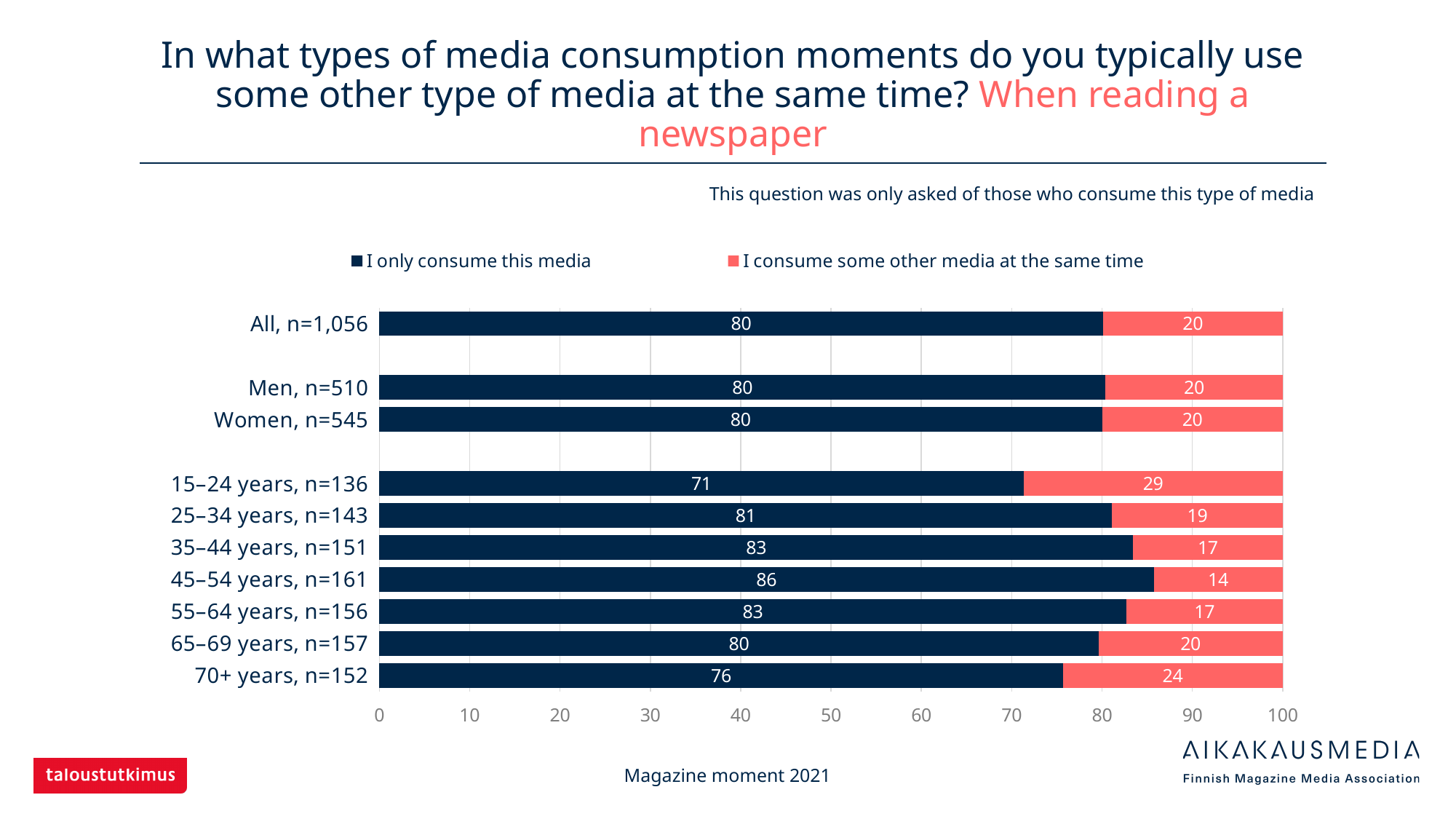
What colour represents "I consume some other media at the same time" in the chart? Red (coral) What is the value for "I only consume this media" for All, n=1,056? 80 What is the value for "I only consume this media" for the 15–24 years group? 71 Which age group has the highest value for "I only consume this media"? 45–54 years, n=161 How many series does the legend list? 2 What kind of chart is shown on the slide? Stacked bar chart Which age group has the lowest value for "I only consume this media"? 15–24 years, n=136 What is the difference between the "I consume some other media at the same time" values for the 15–24 years group and the 45–54 years group? 15 What is the value for "I consume some other media at the same time" for the 70+ years group? 24 Which is larger: the "I only consume this media" value for 25–34 years or for 70+ years? 25–34 years What is the total of the stacked bar for the 35–44 years group? 100 How many categories (bars) are shown in the chart? 10